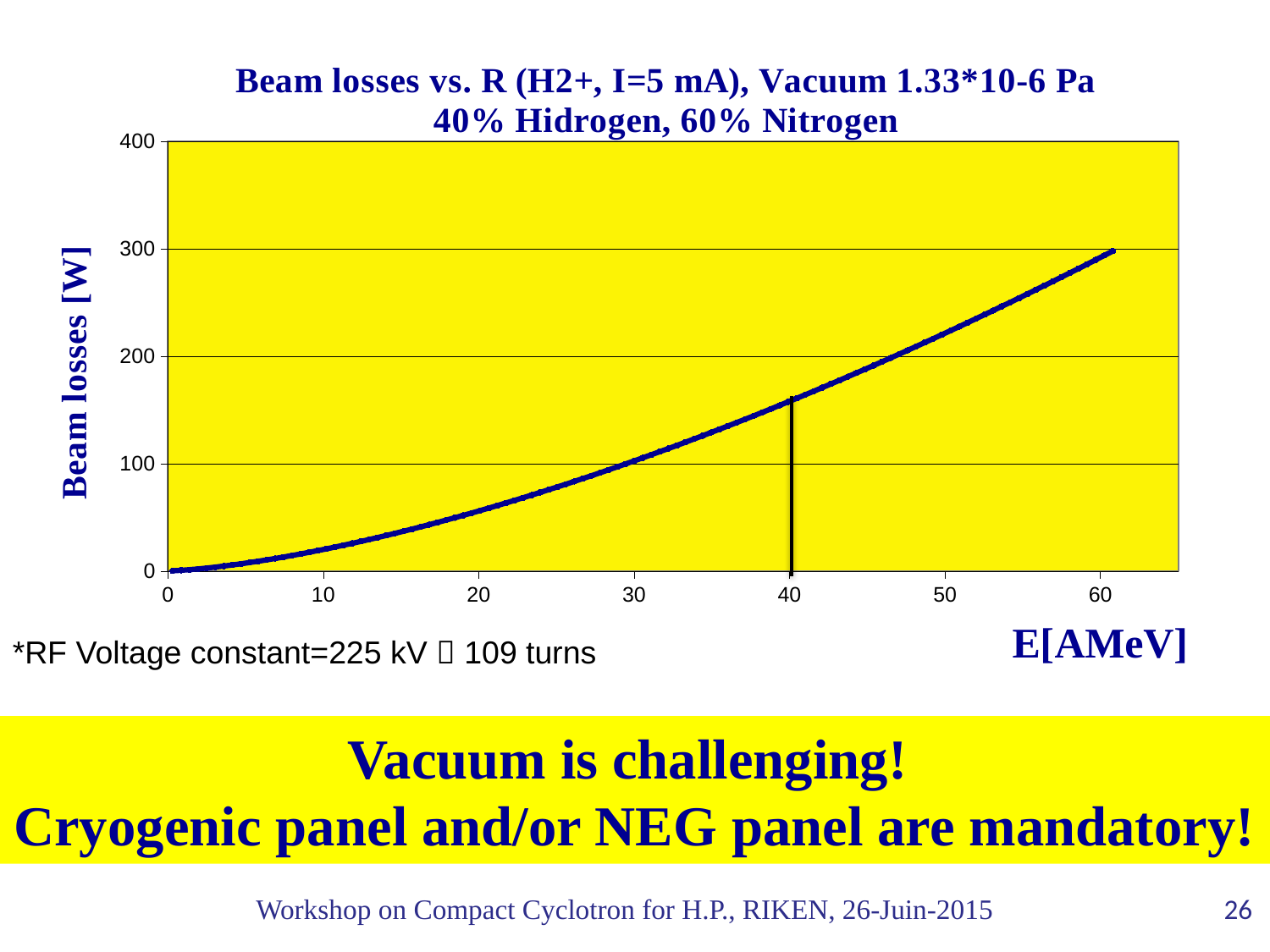
Is the beam loss value at E = 50 AMeV greater or less than 200 W? greater Is the beam loss value at E = 10 AMeV greater or less than 100 W? less Do the beam losses rise or fall as E[AMeV] increases along the x axis? rise Which has higher beam losses, E = 30 AMeV or E = 50 AMeV? E = 50 AMeV What is the highest tick value shown on the vertical axis? 400 At which end of the x axis are the beam losses lowest, E = 0 or E = 60 AMeV? E = 0 Is the beam loss value at E = 40 AMeV greater or less than 100 W? greater What kind of chart is shown on the slide? line chart What is the label of the vertical axis of the chart? Beam losses [W]